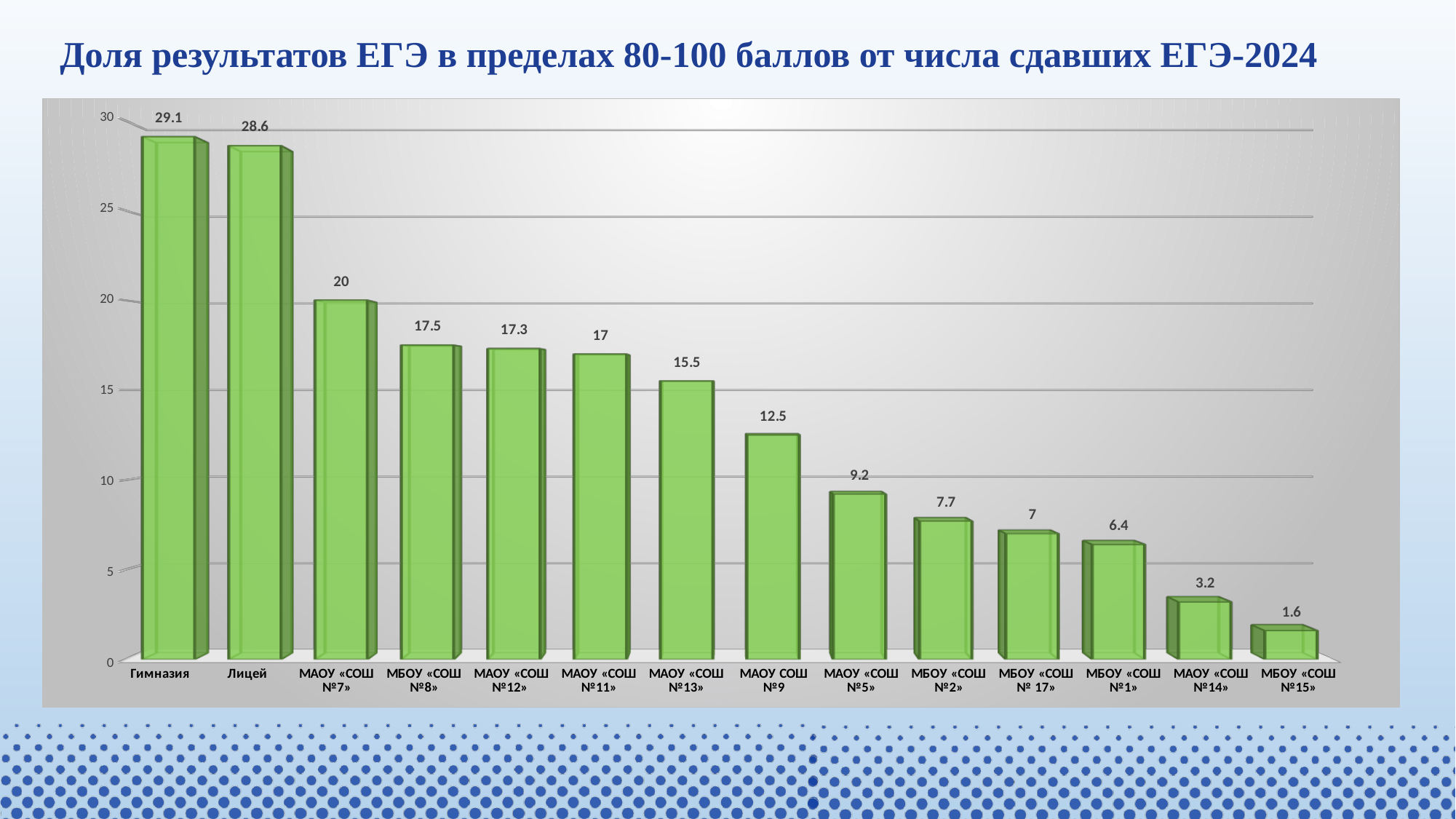
Do the values rise or fall from left to right along the x axis? fall What is the value for МАОУ «СОШ №13»? 15.5 Which is larger, the value for МБОУ «СОШ №2» or the value for МБОУ «СОШ № 17»? МБОУ «СОШ №2» What is the value for МБОУ «СОШ №1»? 6.4 What kind of chart is shown on the slide? bar chart How many categories are shown in the chart? 14 What is the difference between the values for Гимназия and Лицей? 0.5 What is the difference between the values for МАОУ «СОШ №7» and МАОУ СОШ №9? 7.5 What is the value for Гимназия? 29.1 Is the value for МАОУ «СОШ №5» greater or less than 10? less Which category has the lowest value? МБОУ «СОШ №15» Which category has the highest value? Гимназия